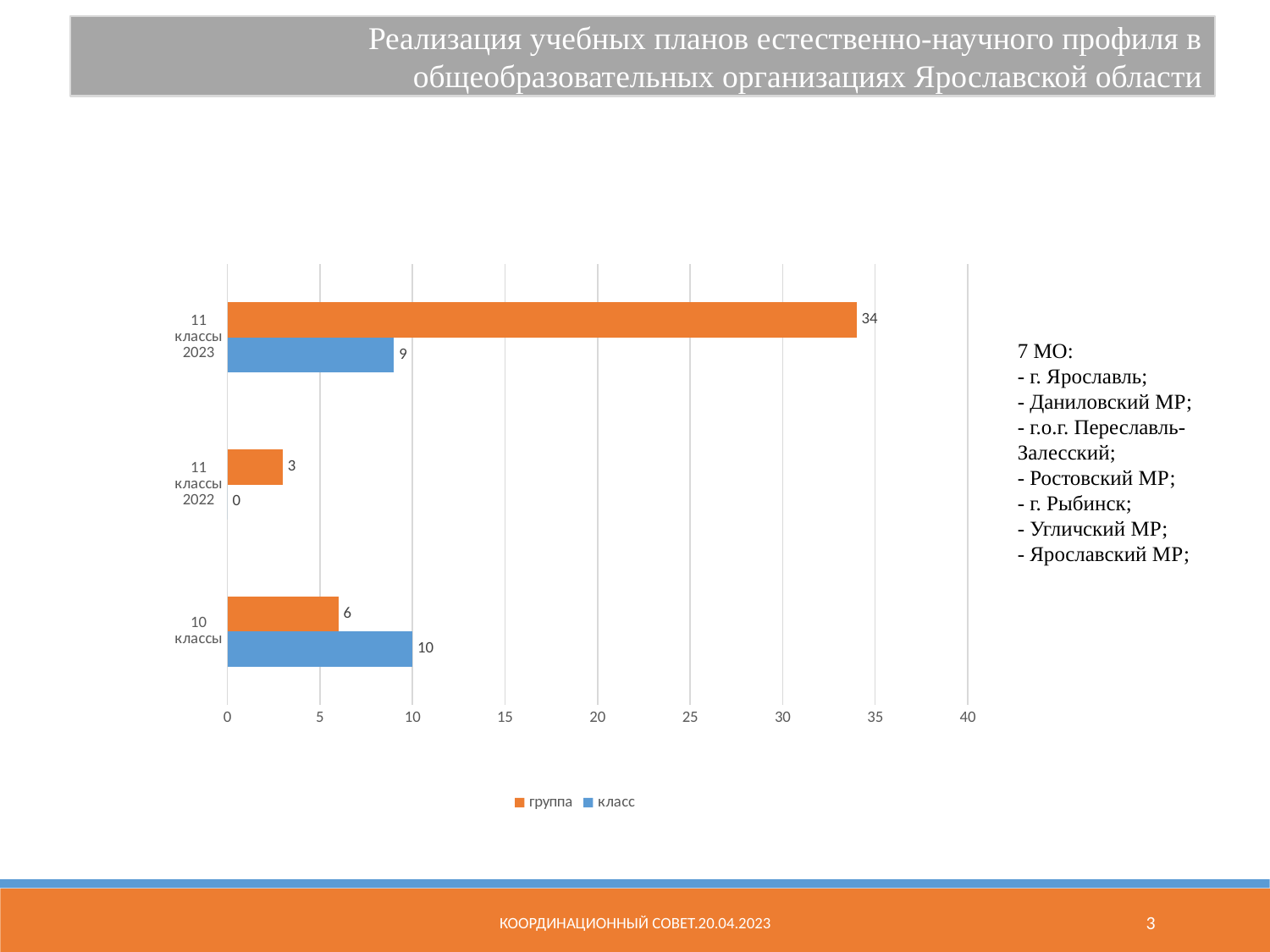
What is the difference between the 'группа' and 'класс' values for '11 классы 2023'? 25 Which category has the lowest value for the 'класс' series? 11 классы 2022 How many categories are shown on the chart? 3 For '10 классы', which series has the larger value, 'группа' or 'класс'? класс What is the value of the 'класс' series for '11 классы 2022'? 0 What type of chart is shown on the slide? bar chart Which category has the highest value for the 'группа' series? 11 классы 2023 How many series does the legend list? 2 What is the value of the 'группа' series for '11 классы 2023'? 34 What is the value of the 'группа' series for '11 классы 2022'? 3 What colour are the bars for the 'группа' series? orange What is the value of the 'класс' series for '10 классы'? 10